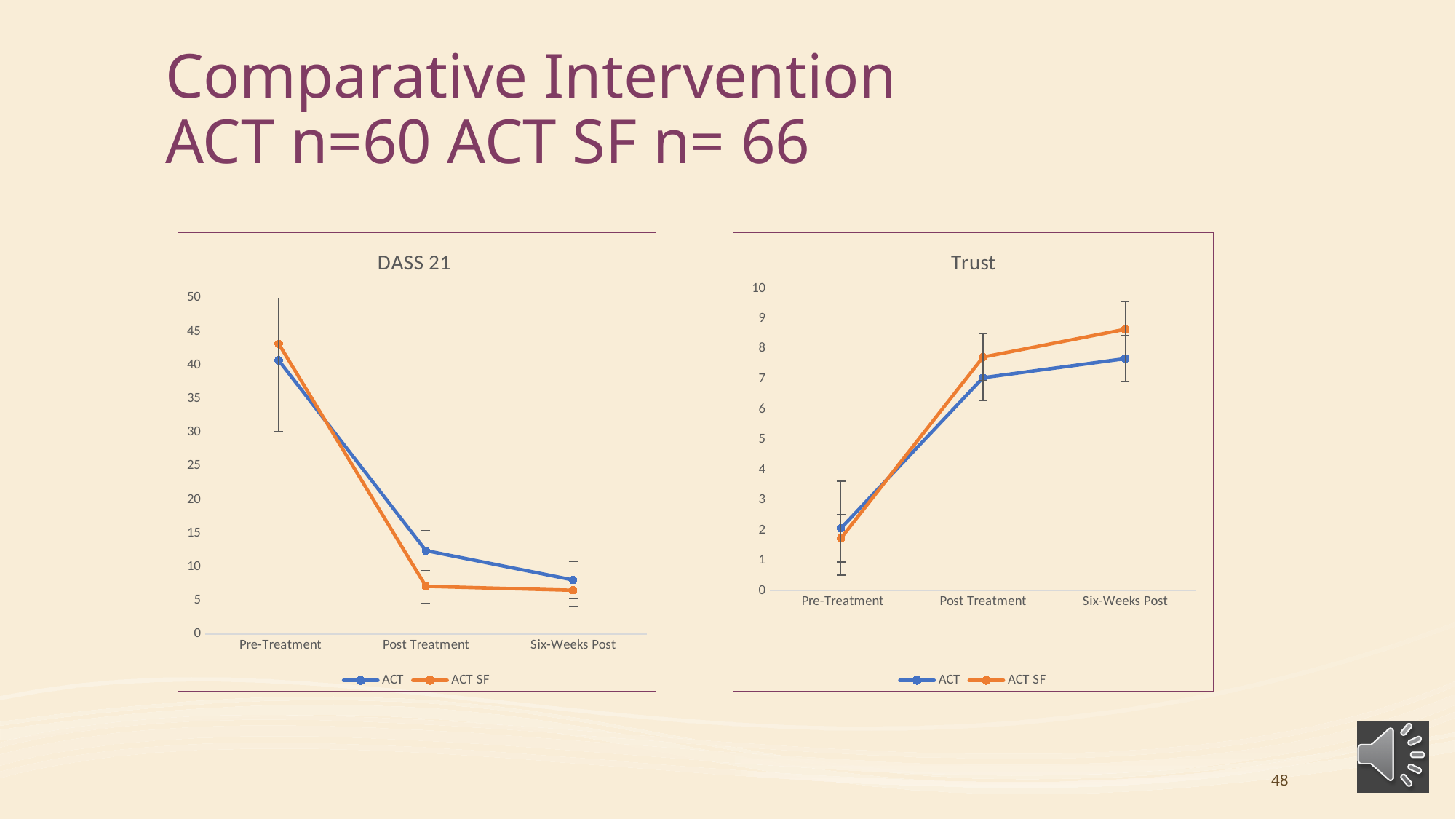
In the DASS 21 chart, is the ACT SF value at Post Treatment greater or less than 10? less In the DASS 21 chart, do the ACT values rise or fall from Pre-Treatment to Six-Weeks Post? fall How many time points are shown on the x axis of the DASS 21 chart? 3 In the DASS 21 chart, is the ACT value at Pre-Treatment greater or less than 35? greater What kind of chart is the DASS 21 chart? line chart In the Trust chart, is the ACT value at Pre-Treatment greater or less than 3? less In the DASS 21 chart, which series has the higher value at Post Treatment, ACT or ACT SF? ACT How many series does the legend of the Trust chart list? 2 In the DASS 21 chart, at which time point is the ACT value highest? Pre-Treatment In the Trust chart, which series has the higher value at Six-Weeks Post, ACT or ACT SF? ACT SF In the Trust chart, do the ACT SF values rise or fall from Pre-Treatment to Six-Weeks Post? rise In the Trust chart, at which time point is the ACT SF value highest? Six-Weeks Post